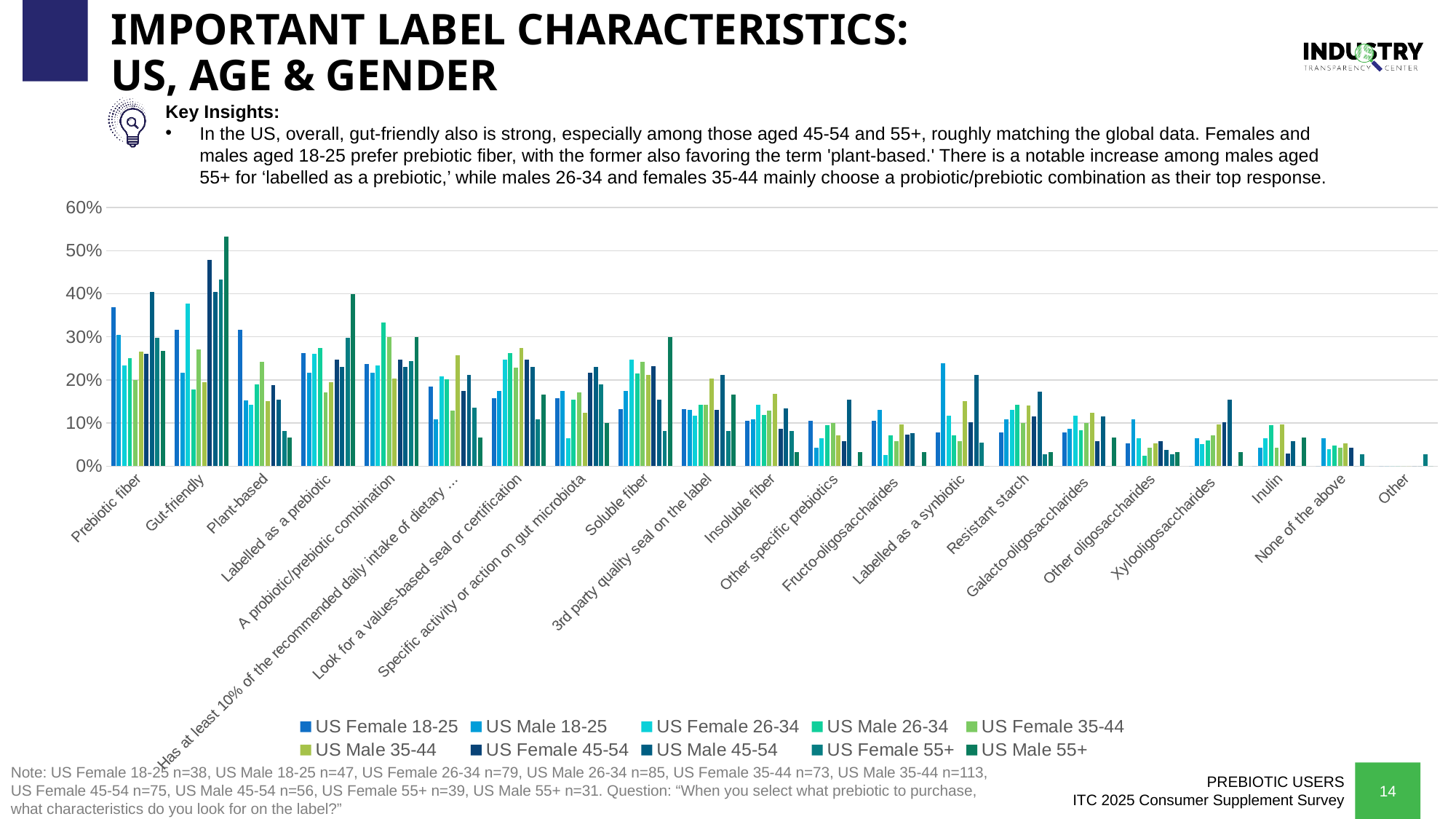
Is the value for US Female 18-25 for Prebiotic fiber greater or less than 30%? greater Which series has the highest value for Gut-friendly? US Male 55+ What is the highest value shown on the y axis? 60% Is the value for US Male 55+ for Gut-friendly greater or less than 50%? greater How many label characteristic categories are shown along the x axis? 21 Is the value for US Male 55+ for Other greater or less than 10%? less For Prebiotic fiber, which is larger: US Female 18-25 or US Male 18-25? US Female 18-25 How many series does the legend list? 10 Which category contains the tallest bar in the chart? Gut-friendly What kind of chart is shown on the slide? bar chart